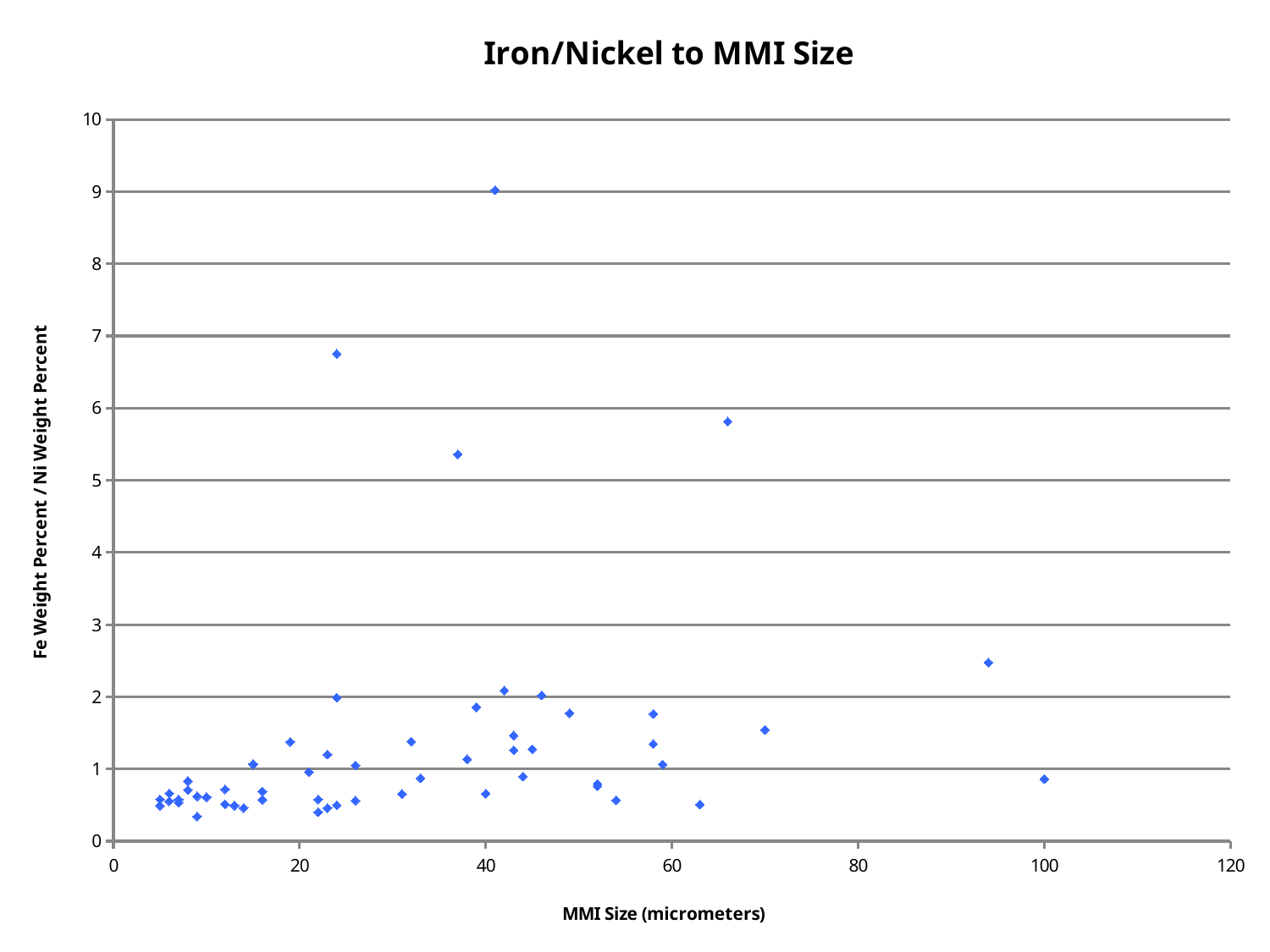
How many points have a y value above 5? 4 How many points have an MMI size greater than 80? 2 What kind of chart is shown on the slide? Scatter chart Is the y value of the point near MMI size 94 greater or less than 2? greater Is the y value of the point near MMI size 66 greater or less than 5? greater Which has the higher y value: the highest point near MMI size 41 or the highest point near MMI size 24? The point near MMI size 41 Is the y value of the highest point near MMI size 24 greater or less than 6? greater What is the label of the x axis? MMI Size (micrometers) What is the title of the chart? Iron/Nickel to MMI Size